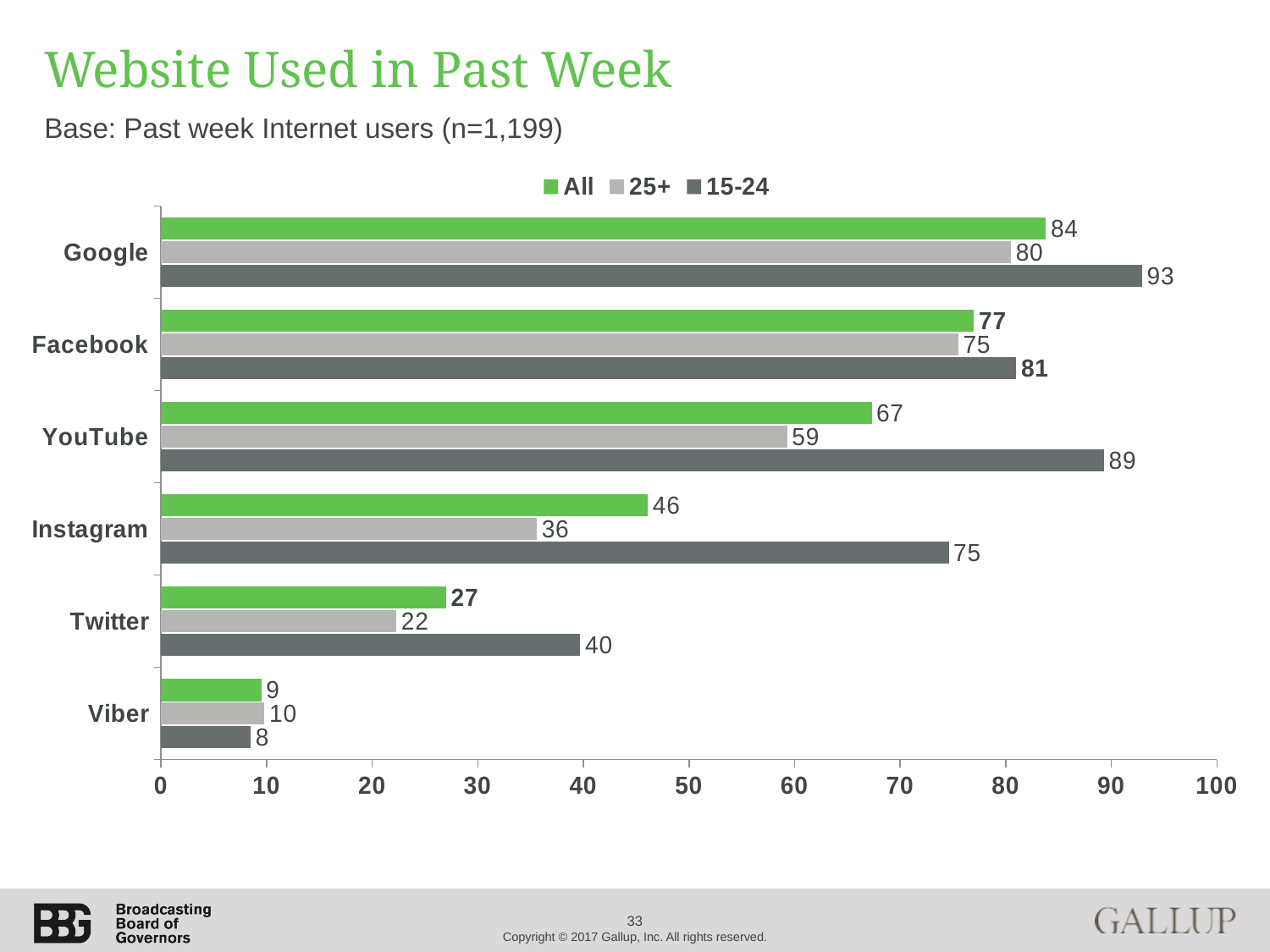
What is the title of the chart? Website Used in Past Week Which is larger for Twitter: the All value or the 15-24 value? 15-24 What kind of chart is shown on the slide? Bar chart Which website has the lowest value in the All series? Viber How many series does the legend list? 3 What is the value for Google in the All series? 84 Which series is shown in green? All Which website has the highest value in the 15-24 series? Google What is the value for Instagram in the 15-24 series? 75 What is the value for YouTube in the 25+ series? 59 How many websites are shown on the chart? 6 What is the difference between the 15-24 and 25+ values for Instagram? 39